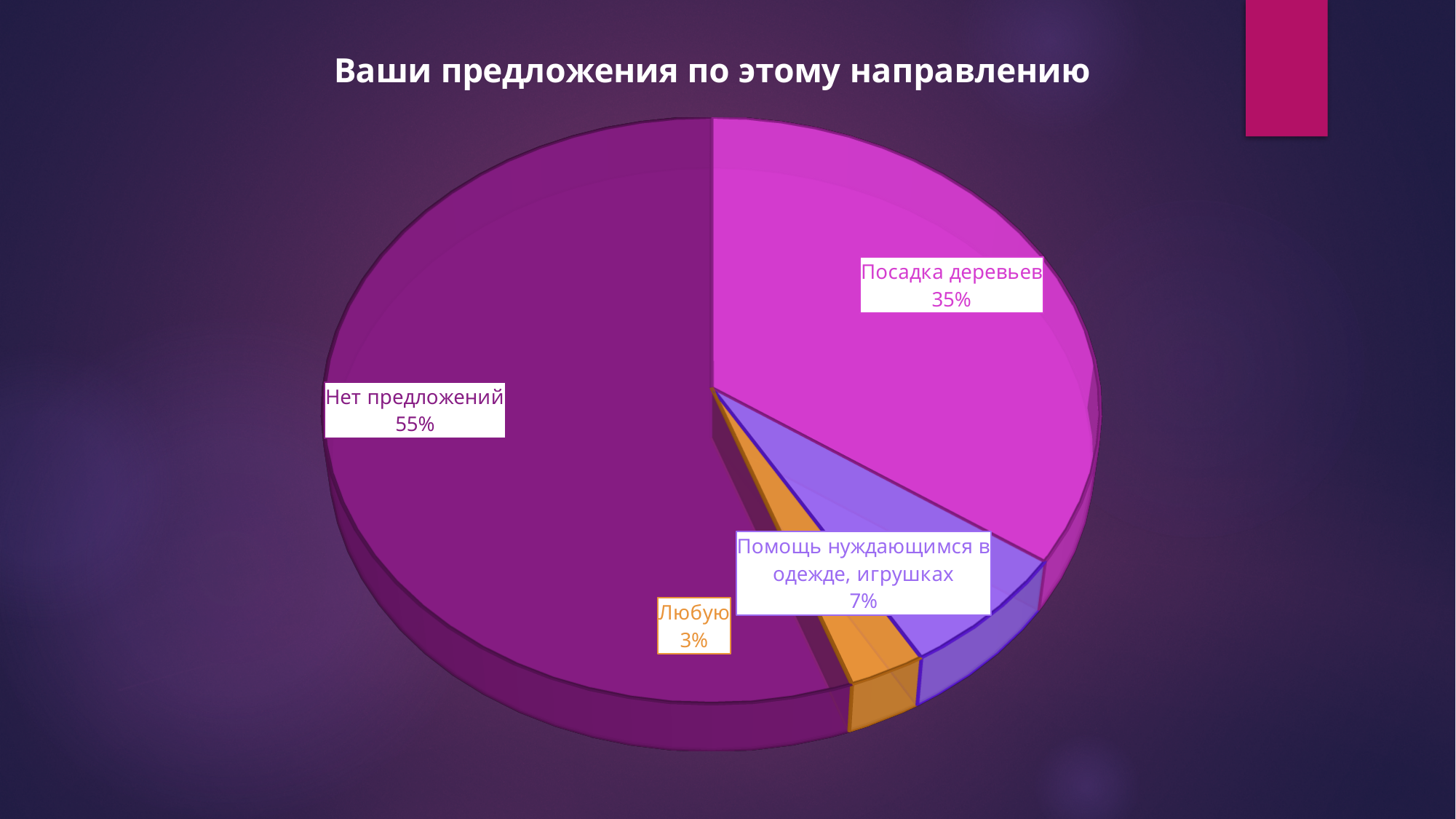
What share of the pie does "Любую" have? 3% What colour is the slice for "Любую"? Orange Which is larger: the share for "Помощь нуждающимся в одежде, игрушках" or the share for "Любую"? Помощь нуждающимся в одежде, игрушках What kind of chart is shown on the slide? Pie chart What share of the pie does "Помощь нуждающимся в одежде, игрушках" have? 7% What share of the pie does "Нет предложений" have? 55% What is the title of the chart? Ваши предложения по этому направлению How many categories are shown in the pie chart? 4 Which category has the largest slice of the pie? Нет предложений What is the difference between the shares of "Нет предложений" and "Посадка деревьев"? 20% Which category has the smallest slice of the pie? Любую